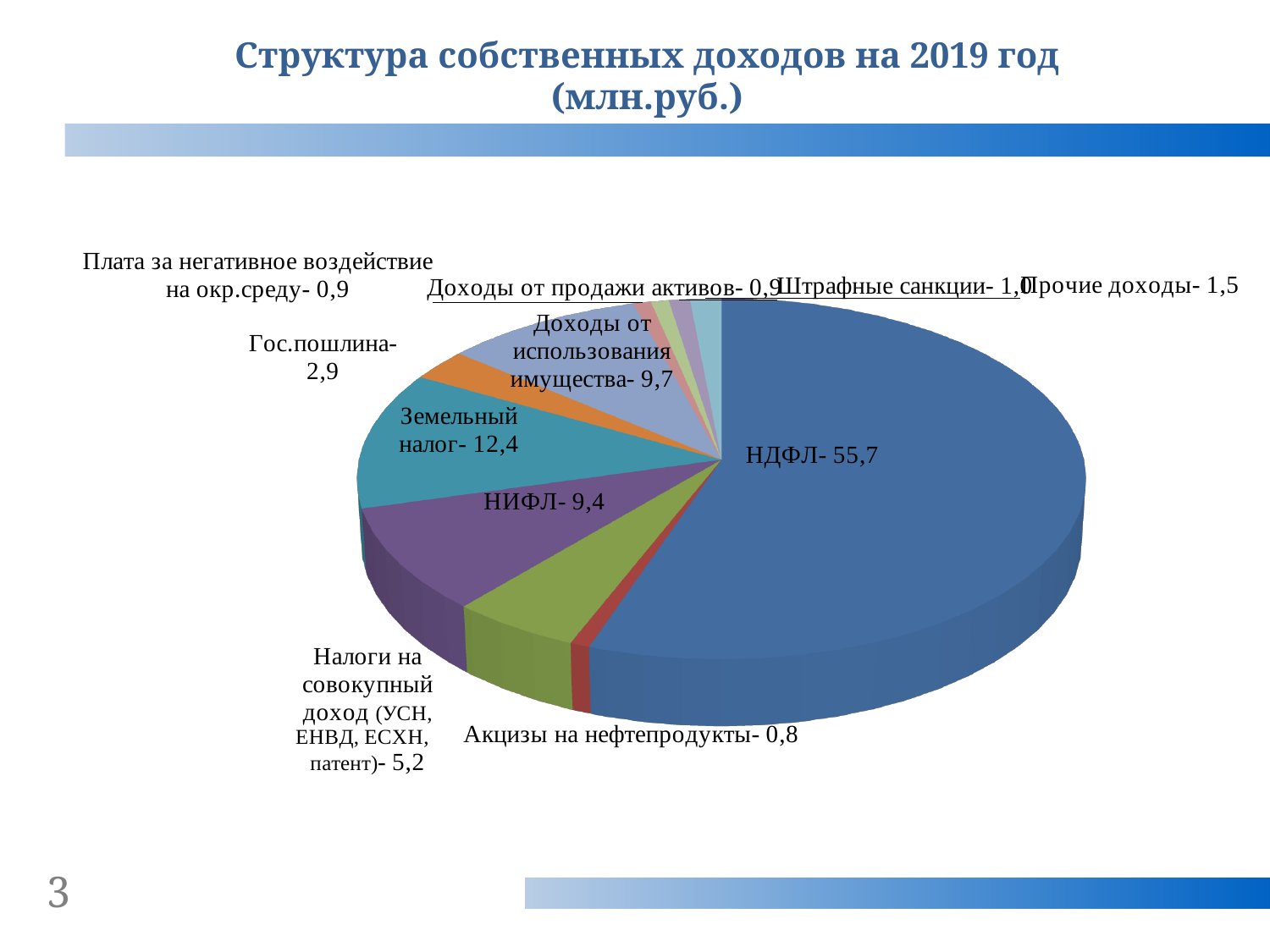
What is the value for Земельный налог? 12,4 What is the value for НДФЛ? 55,7 What is the value for Гос.пошлина? 2,9 How many slices does the pie chart have? 11 Which category has the smallest value? Акцизы на нефтепродукты What is the title of the chart? Структура собственных доходов на 2019 год (млн.руб.) What is the value for Налоги на совокупный доход (УСН, ЕНВД, ЕСХН, патент)? 5,2 Which is larger: Доходы от использования имущества or НИФЛ? Доходы от использования имущества Which category has the largest slice of the pie? НДФЛ What is the difference between the values for НДФЛ and Земельный налог? 43,3 What is the difference between the values for Земельный налог and НИФЛ? 3,0 What kind of chart is shown on the slide? pie chart